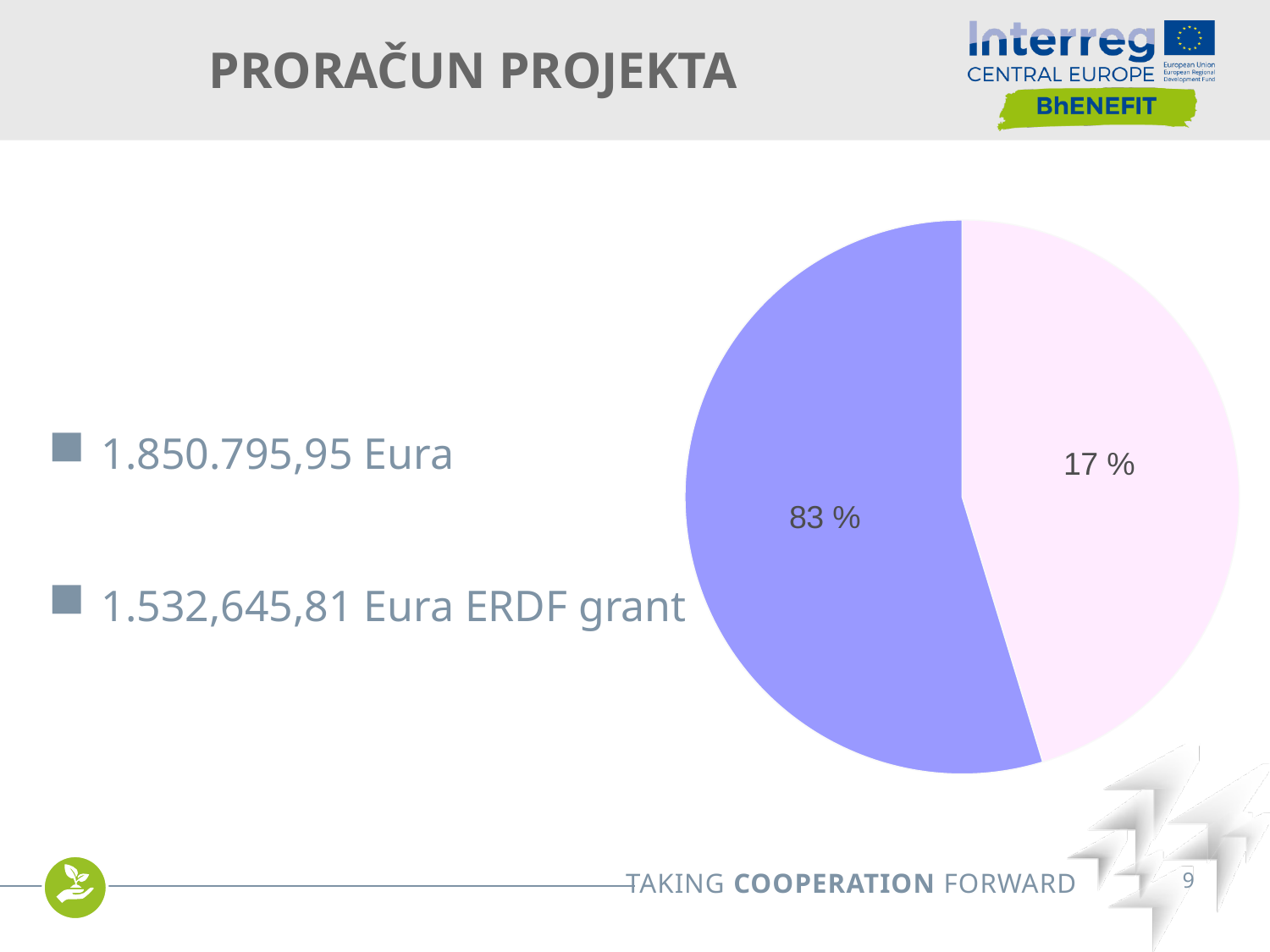
Does the pie chart have a legend? No Which slice is larger, the purple one or the light pink one? the purple one Is the purple slice greater or less than 50 % of the pie? greater What is the share of the largest slice of the pie chart? 83 % What is the share of the smallest slice of the pie chart? 17 % What do the two slice percentages of the pie chart add up to? 100 % What share of the pie does the purple slice represent? 83 % What is the difference in percentage points between the two slices of the pie chart? 66 What kind of chart is shown on the slide? pie chart How many slices does the pie chart have? 2 What share of the pie does the light pink slice represent? 17 %